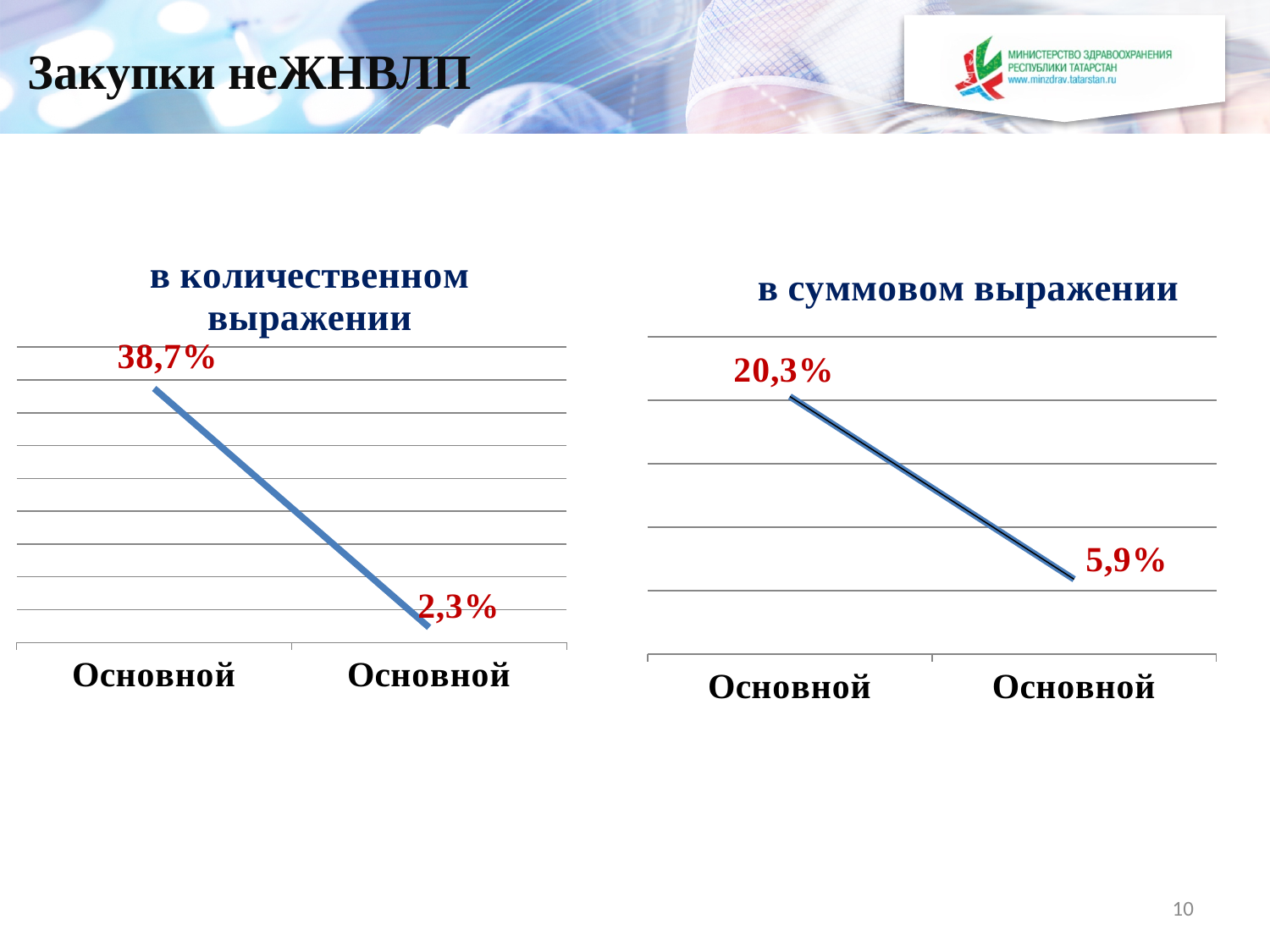
In the chart "в количественном выражении", what is the value of the second (right) data point? 2,3% How many data points are plotted in the chart "в суммовом выражении"? 2 What type of chart is the left chart titled "в количественном выражении"? line chart In the chart "в количественном выражении", does the line rise or fall from left to right? fall Which is larger: the first data point of the chart "в количественном выражении" or the first data point of the chart "в суммовом выражении"? в количественном выражении (38,7%) In the chart "в суммовом выражении", does the line rise or fall from left to right? fall In the chart "в суммовом выражении", what is the value of the first (left) data point? 20,3% In the chart "в количественном выражении", what is the difference between the first and second data points? 36,4% In the chart "в количественном выражении", what is the value of the first (left) data point? 38,7% What type of chart is the right chart titled "в суммовом выражении"? line chart In the chart "в суммовом выражении", what is the value of the second (right) data point? 5,9% In the chart "в суммовом выражении", what is the difference between the first and second data points? 14,4%